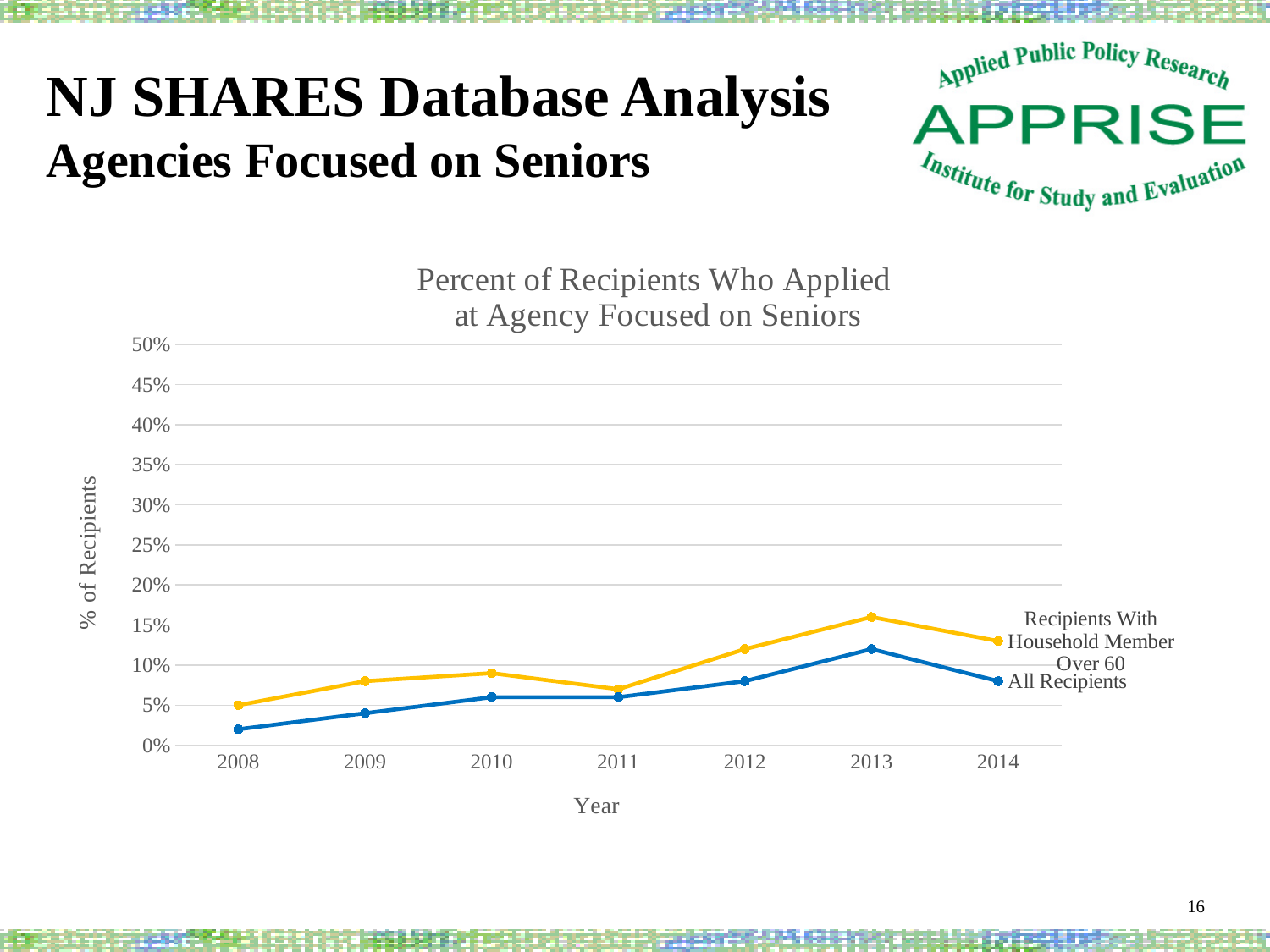
Is the value for All Recipients in 2008 greater or less than 5%? less What is the title of the chart? Percent of Recipients Who Applied at Agency Focused on Seniors Is the value for Recipients With Household Member Over 60 in 2013 greater or less than 15%? greater Is the value for All Recipients in 2013 greater or less than 10%? greater How many years are plotted along the x axis? 7 In 2014, which series has the larger value: Recipients With Household Member Over 60 or All Recipients? Recipients With Household Member Over 60 What kind of chart is shown on the slide? line chart How many series does the legend list? 2 In which year does the Recipients With Household Member Over 60 series reach its highest value? 2013 In which year is the All Recipients series at its lowest? 2008 Does the All Recipients series rise or fall from 2013 to 2014? fall